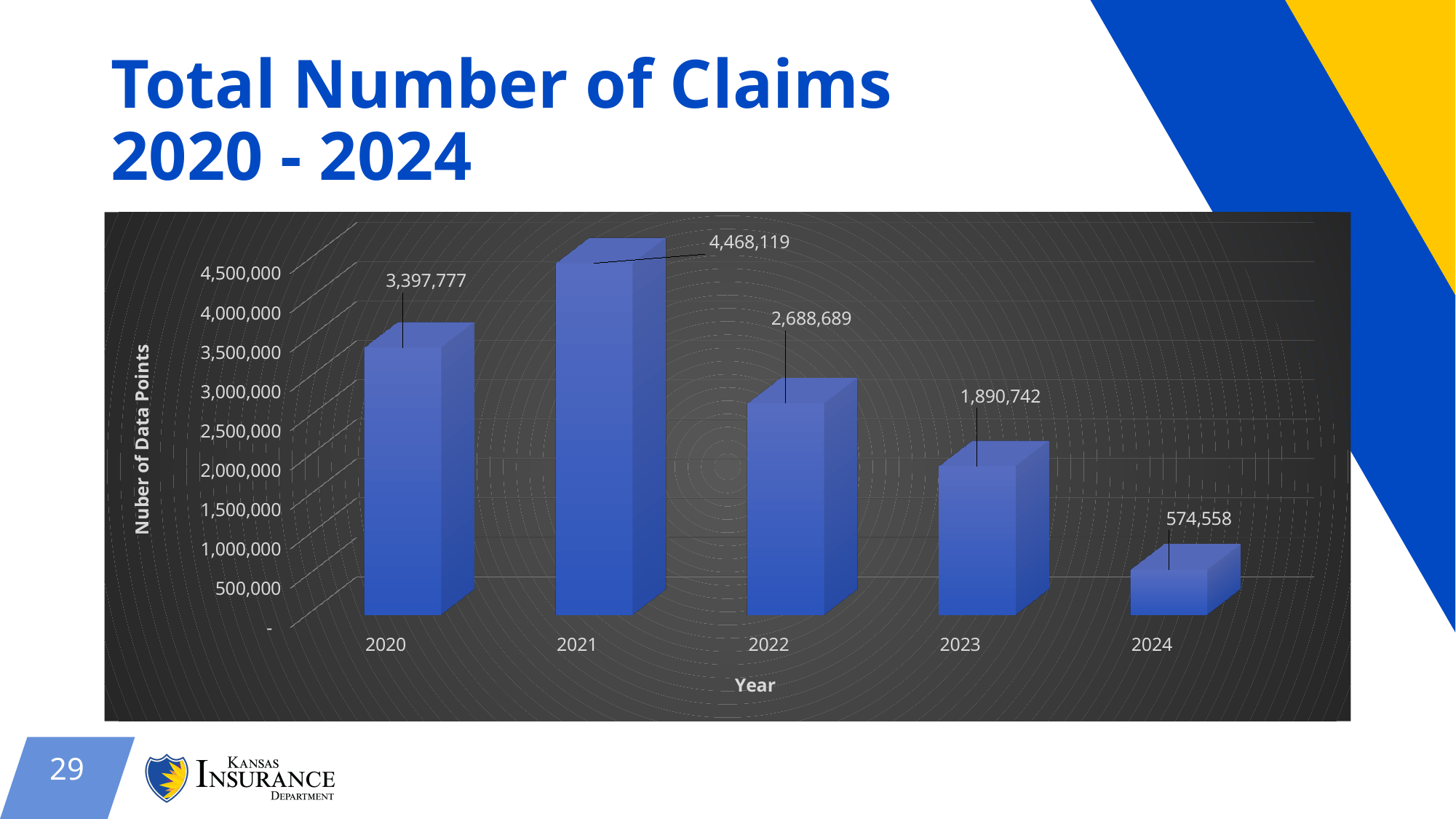
How many years are shown on the x axis? 5 Which year has the lowest number of claims? 2024 Is the value for 2023 greater or less than 2,000,000? less Do the values rise or fall from 2021 to 2024? fall What is the difference between the values for 2023 and 2024? 1,316,184 Which year has the highest number of claims? 2021 What is the value shown for 2024? 574,558 Which is larger, the value for 2020 or the value for 2022? 2020 What kind of chart is shown on the slide? bar chart What is the difference between the values for 2021 and 2020? 1,070,342 What is the total number of claims for 2021? 4,468,119 What is the value shown for 2022? 2,688,689